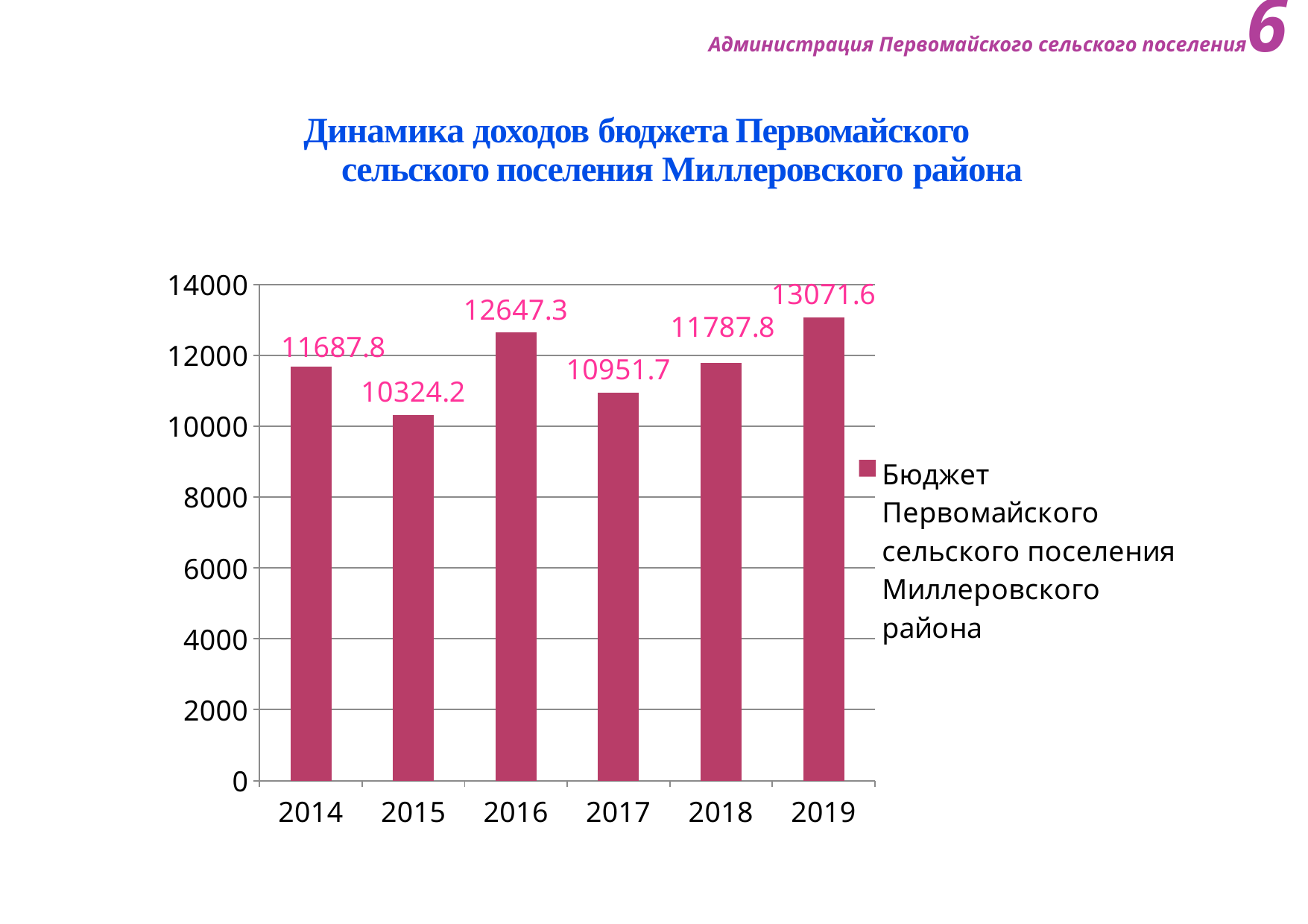
What is the difference between the values for 2016 and 2015? 2323.1 What is the value for 2014? 11687.8 Is the value for 2015 greater or less than 12000? less What is the value for 2017? 10951.7 How many years are shown on the x axis? 6 Which is larger, the value for 2016 or the value for 2017? 2016 What is the value for 2019? 13071.6 What kind of chart is shown on the slide? bar chart How many series does the legend list? 1 What is the difference between the values for 2019 and 2018? 1283.8 Which year has the lowest value? 2015 Which year has the highest value? 2019